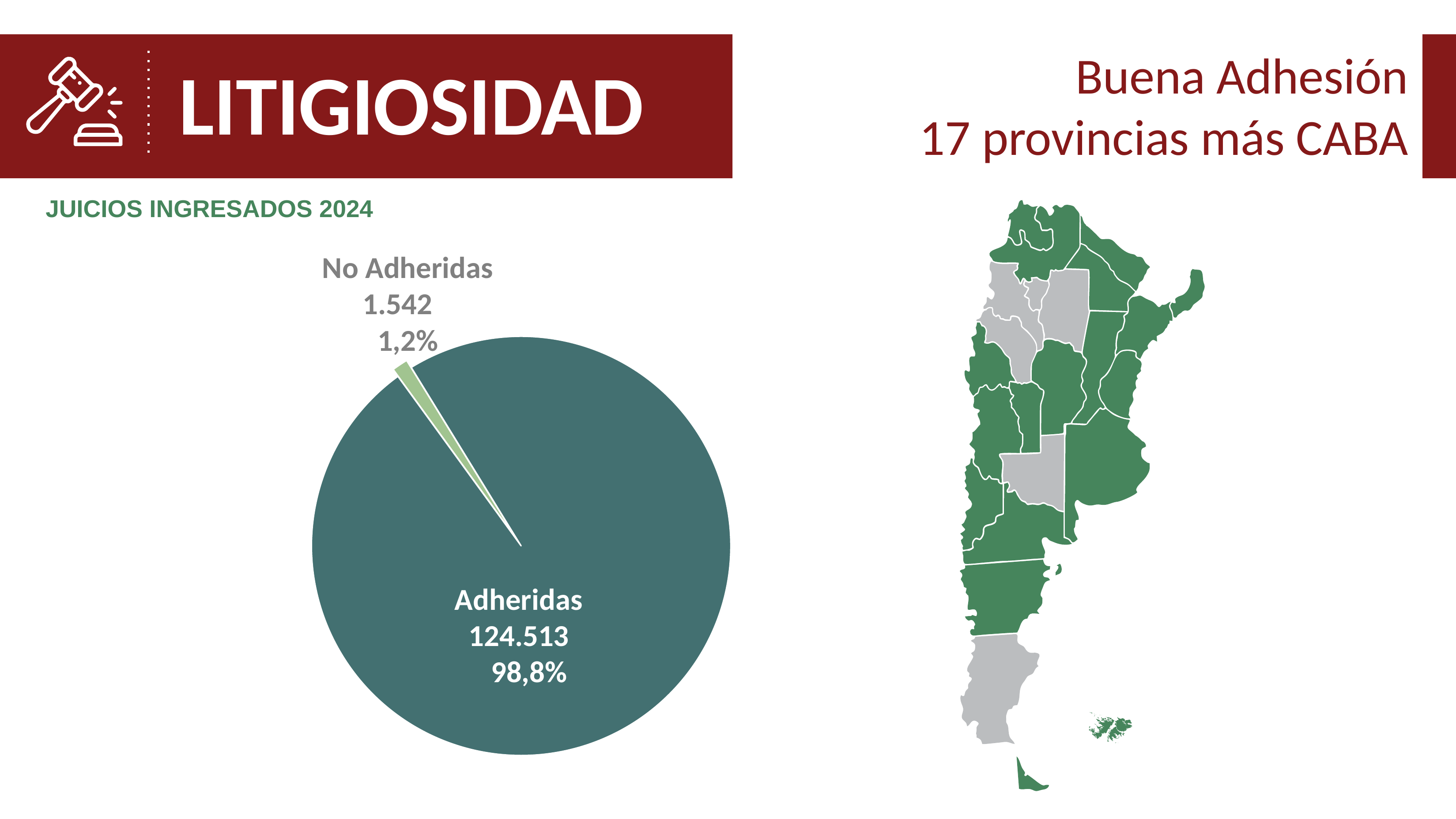
What is the title of the pie chart? JUICIOS INGRESADOS 2024 Which is larger in the pie chart, Adheridas or No Adheridas? Adheridas What is the value for No Adheridas in the pie chart? 1.542 Which slice of the pie chart is the smallest? No Adheridas What is the difference between the Adheridas and No Adheridas values in the pie chart? 122.971 Which slice of the pie chart is the largest? Adheridas What share of the pie does No Adheridas represent? 1,2% What kind of chart is shown under 'JUICIOS INGRESADOS 2024'? pie chart How many slices does the pie chart have? 2 What is the value for Adheridas in the pie chart? 124.513 What colour is the No Adheridas slice in the pie chart? light green What share of the pie does Adheridas represent? 98,8%